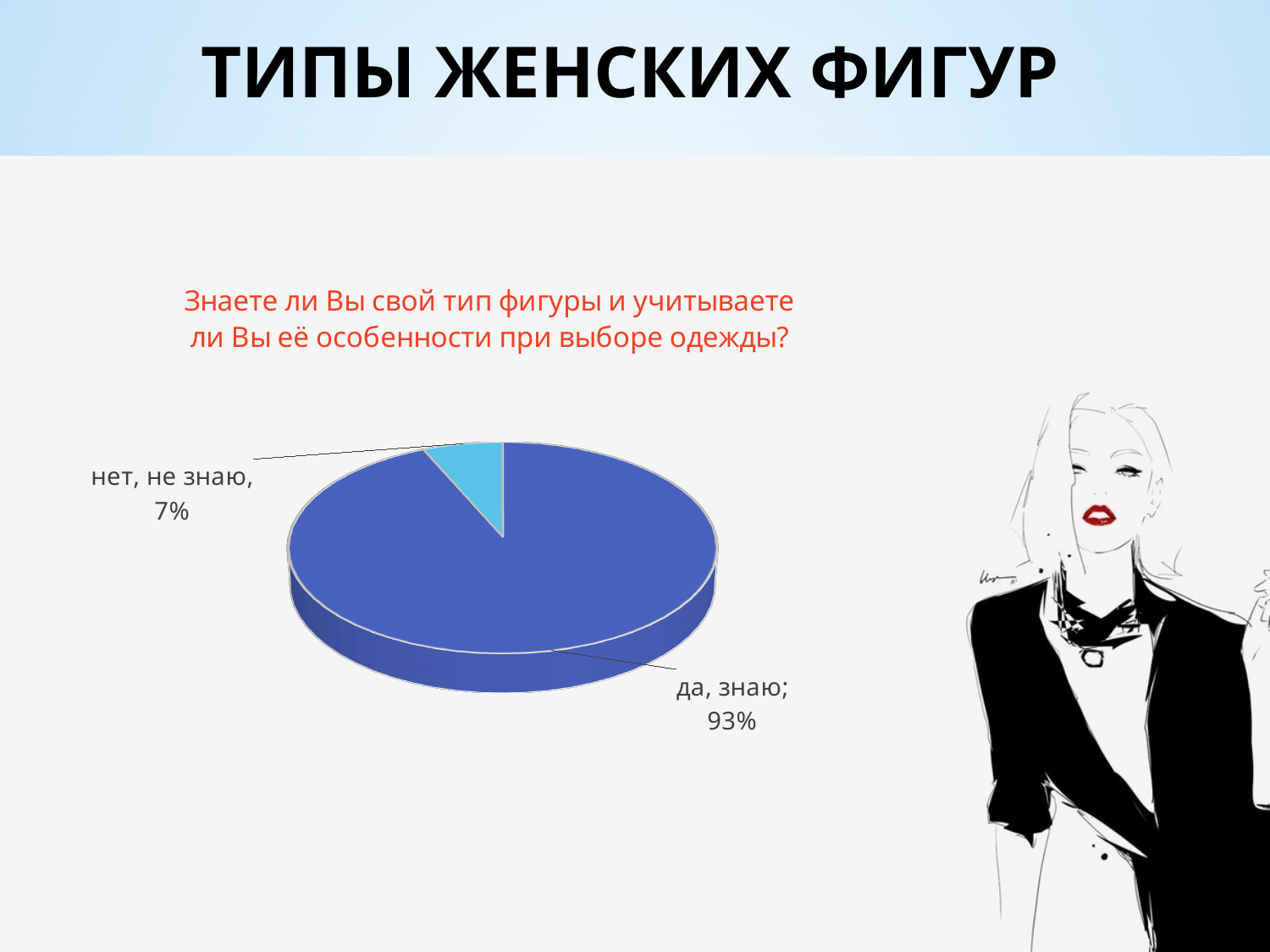
What share of the pie is labelled "да, знаю"? 93% What share of the pie is labelled "нет, не знаю"? 7% Which slice of the pie is the smallest? нет, не знаю Which slice of the pie is the largest? да, знаю How many slices does the pie chart have? 2 What kind of chart is shown on the slide? pie chart What colour is the "нет, не знаю" slice of the pie? light blue What is the total of the two slice percentages shown on the pie chart? 100% What question is the pie chart answering, according to the text above it? Знаете ли Вы свой тип фигуры и учитываете ли Вы её особенности при выборе одежды? What is the difference in percentage points between the "да, знаю" and "нет, не знаю" slices? 86 Which is larger: the "да, знаю" slice or the "нет, не знаю" slice? да, знаю